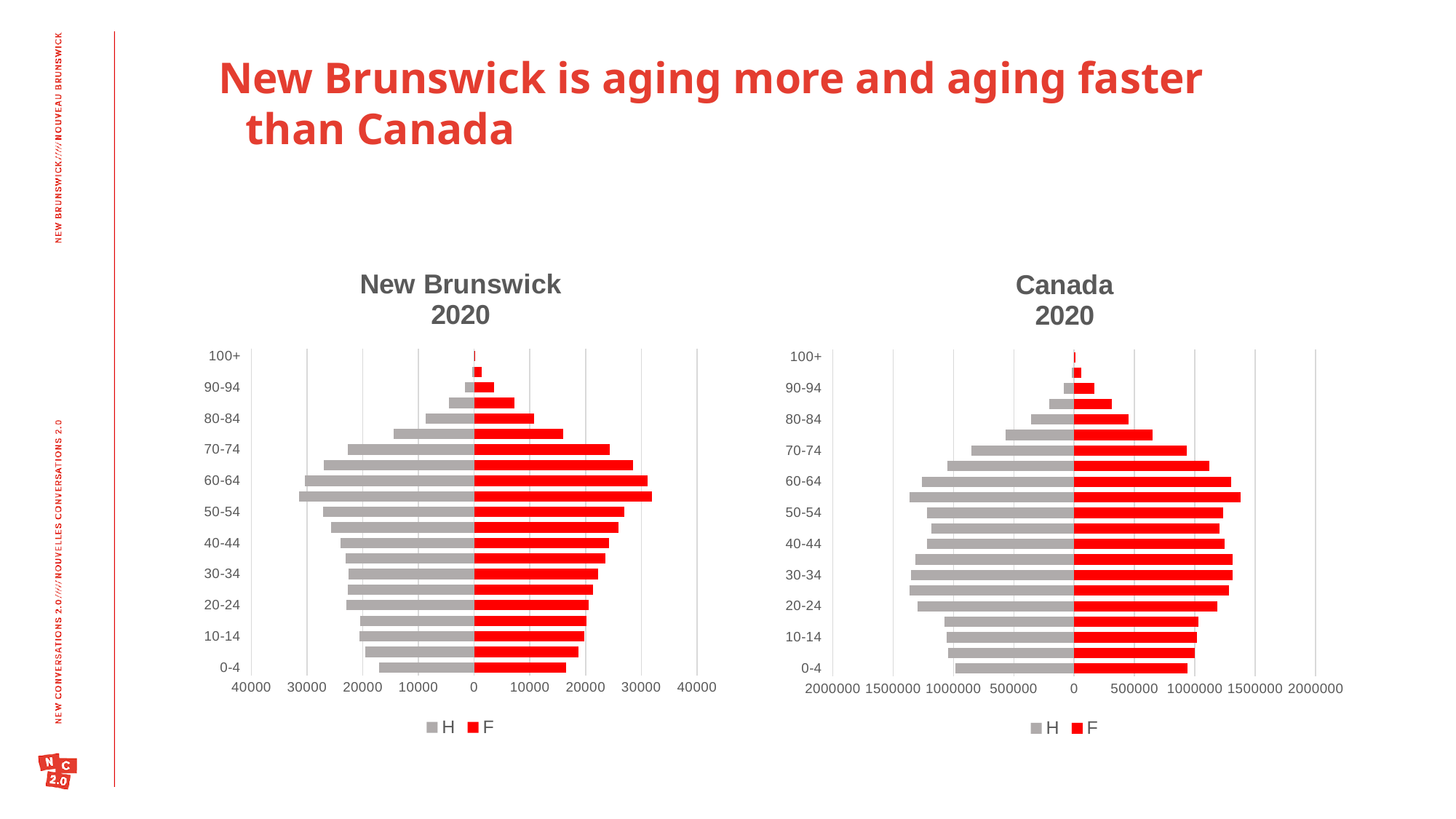
What are the two series named in the legend of the New Brunswick 2020 chart? H and F In the Canada 2020 chart, is the F value for the 60-64 age group greater or less than 1000000? greater In the New Brunswick 2020 chart, which has the larger F value: the 60-64 age group or the 0-4 age group? 60-64 In the Canada 2020 chart, is the H value for the 80-84 age group greater or less than 500000? less In the Canada 2020 chart, which has the larger F value: the 30-34 age group or the 80-84 age group? 30-34 In the New Brunswick 2020 chart, is the F value for the 0-4 age group greater or less than 20000? less How many series does the legend of the Canada 2020 chart list? 2 What kind of chart is the New Brunswick 2020 chart? bar chart In the New Brunswick 2020 chart, what colour are the F bars? red In the Canada 2020 chart, which has the larger H value: the 90-94 age group or the 20-24 age group? 20-24